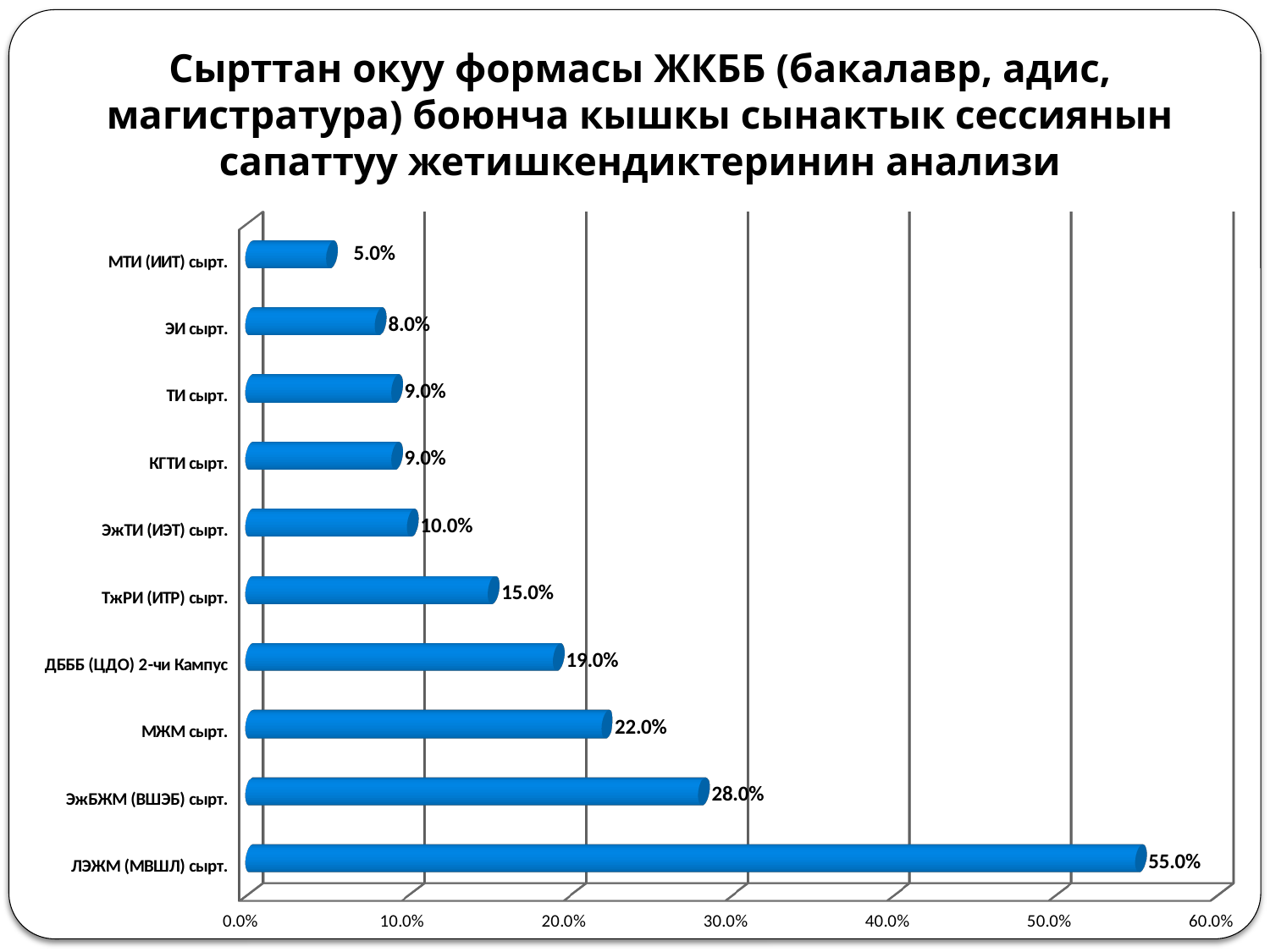
Is the value for ЛЭЖМ (МВШЛ) сырт. greater or less than 50.0%? greater Which category has the highest value? ЛЭЖМ (МВШЛ) сырт. What is the difference between the values for ЭжБЖМ (ВШЭБ) сырт. and МЖМ сырт.? 6.0% What is the value for ДБББ (ЦДО) 2-чи Кампус? 19.0% What is the value for ЛЭЖМ (МВШЛ) сырт.? 55.0% What is the highest value shown on the horizontal axis? 60.0% Which is larger, the value for ТжРИ (ИТР) сырт. or the value for ЭжТИ (ИЭТ) сырт.? ТжРИ (ИТР) сырт. What kind of chart is shown on the slide? bar chart What is the value for ЭИ сырт.? 8.0% What is the value for МТИ (ИИТ) сырт.? 5.0% Which category has the lowest value? МТИ (ИИТ) сырт. How many categories are shown in the chart? 10